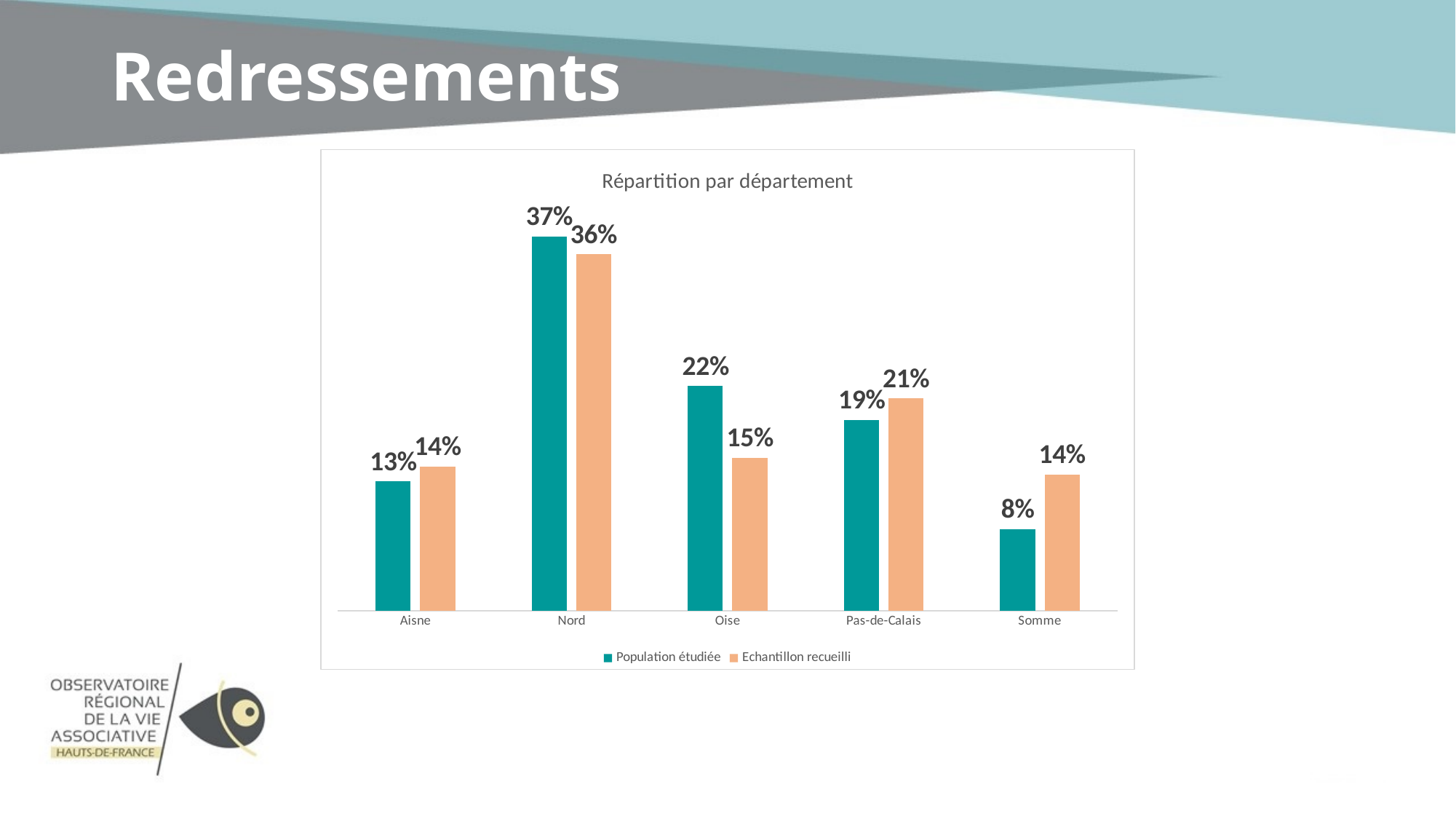
How many series does the legend list? 2 What is the value for Echantillon recueilli in Pas-de-Calais? 21% In Pas-de-Calais, which is larger: Population étudiée or Echantillon recueilli? Echantillon recueilli What is the difference between Population étudiée and Echantillon recueilli in Oise? 7 percentage points Which department has the lowest value for Echantillon recueilli? Aisne and Somme (both 14%) How many departments are shown on the x axis? 5 What is the value for Echantillon recueilli in Oise? 15% What is the title of the chart? Répartition par département What is the value for Population étudiée in Somme? 8% What kind of chart is shown? Bar chart Which department has the highest value for Population étudiée? Nord What is the value for Population étudiée in Nord? 37%